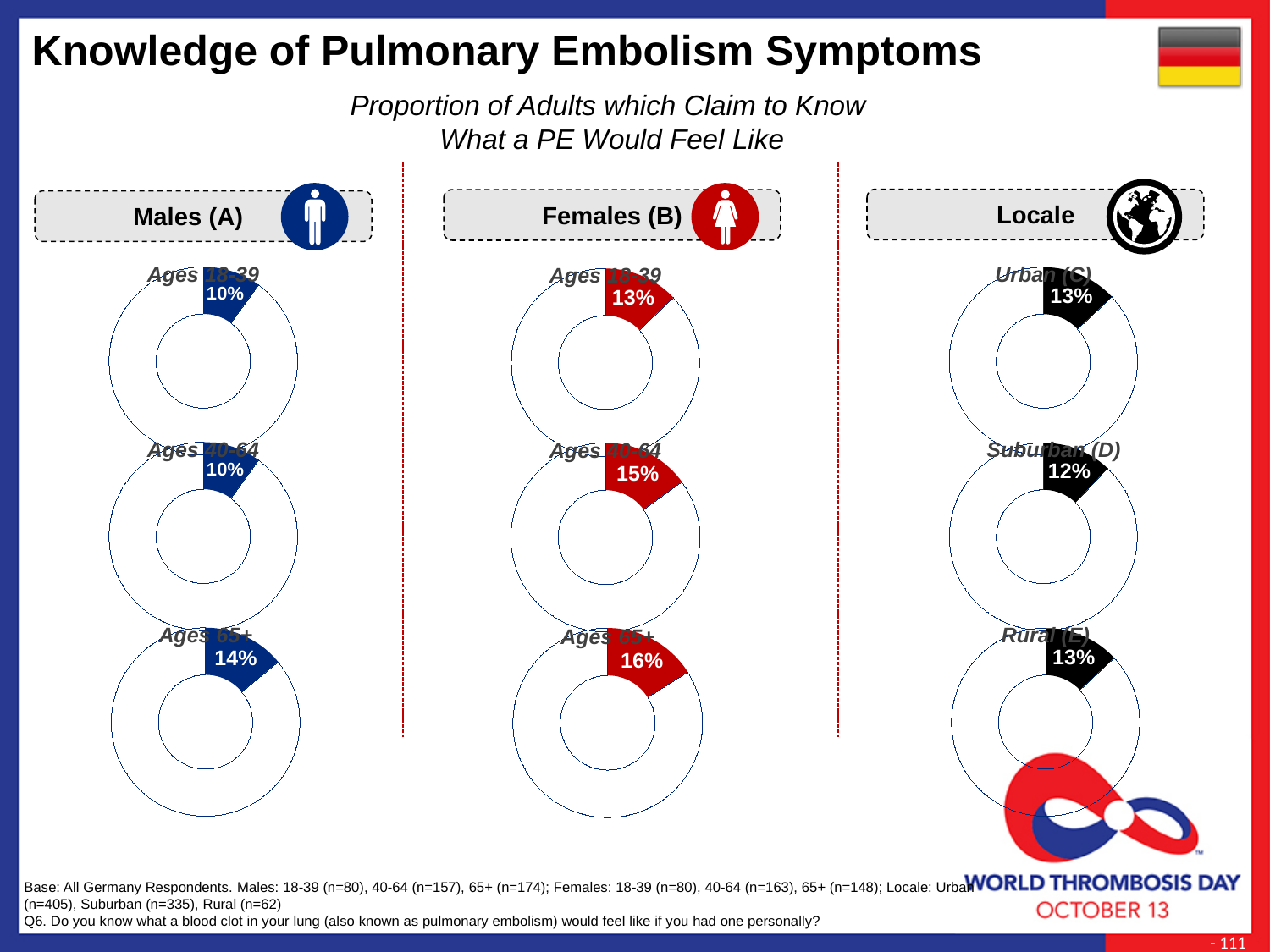
What type of chart is used to show the Males (A) Ages 40-64 value? Donut chart In the Males (A) column, what percentage of adults aged 18-39 claim to know what a PE would feel like? 10% How many donut charts are shown on the slide in total? 9 In the Locale column, what is the value shown for Suburban (D)? 12% In the Females (B) column, what is the value shown for Ages 40-64? 15% Which is larger: the Females (B) Ages 18-39 value or the Males (A) Ages 18-39 value? Females (B) Ages 18-39 What colour is the highlighted slice in the Females (B) donut charts? Red In the Locale column, which locale has the lowest value? Suburban (D) In the Females (B) column, what is the value shown for Ages 65+? 16% In the Females (B) column, which age group has the highest value? Ages 65+ In the Males (A) column, what is the value shown for Ages 65+? 14% What is the difference between the Females (B) Ages 65+ value and the Males (A) Ages 65+ value? 2%